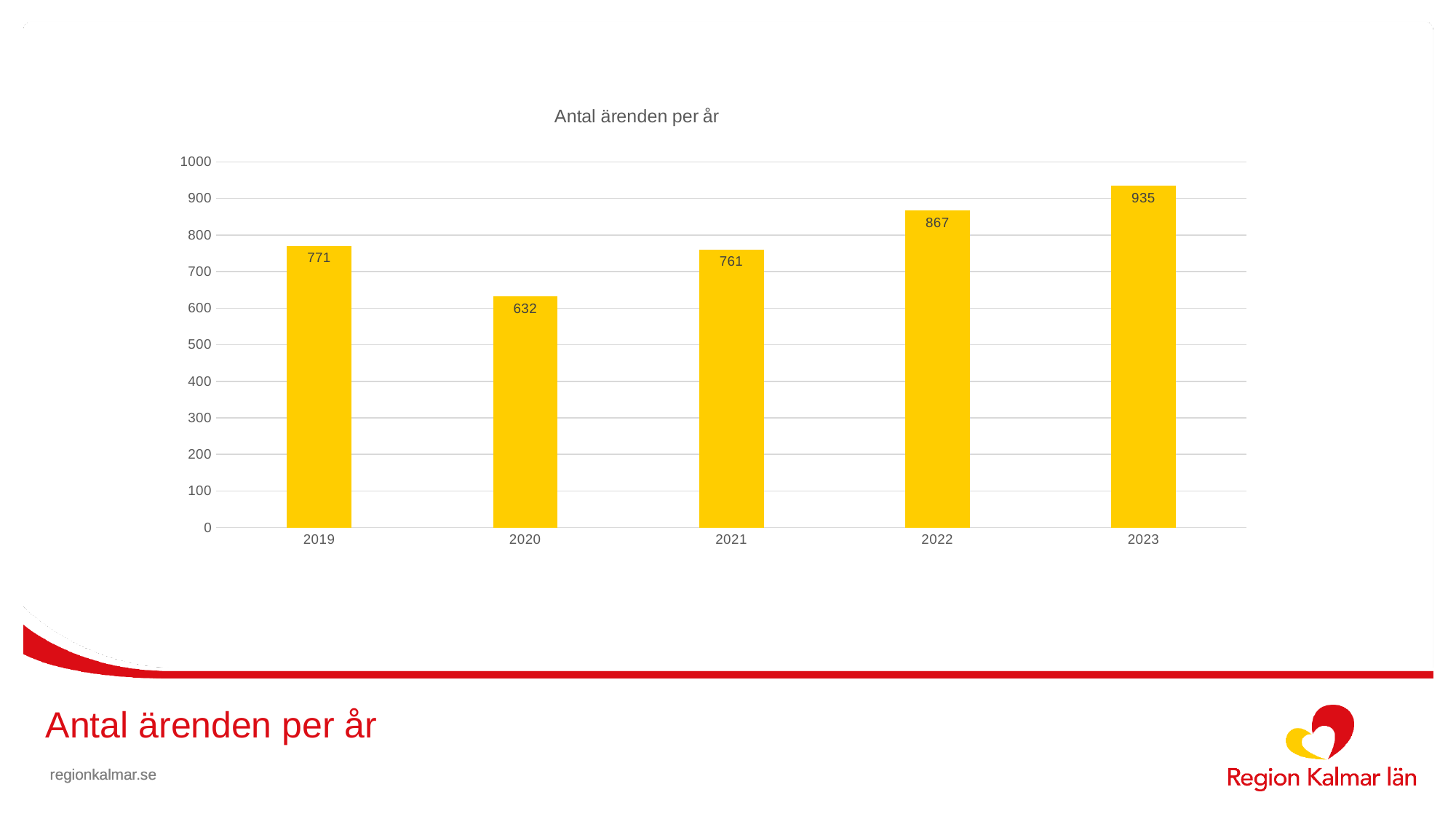
What is the difference between the values for 2023 and 2022? 68 What is the difference between the values for 2019 and 2020? 139 Which year has the lowest value? 2020 What kind of chart is shown on the slide? bar chart What is the value for 2022? 867 Which year has the highest value? 2023 What is the value for 2019? 771 What is the title of the chart? Antal ärenden per år Which is larger, the value for 2019 or the value for 2021? 2019 Is the value for 2021 greater or less than 800? less How many years are shown on the x axis? 5 What is the value for 2020? 632